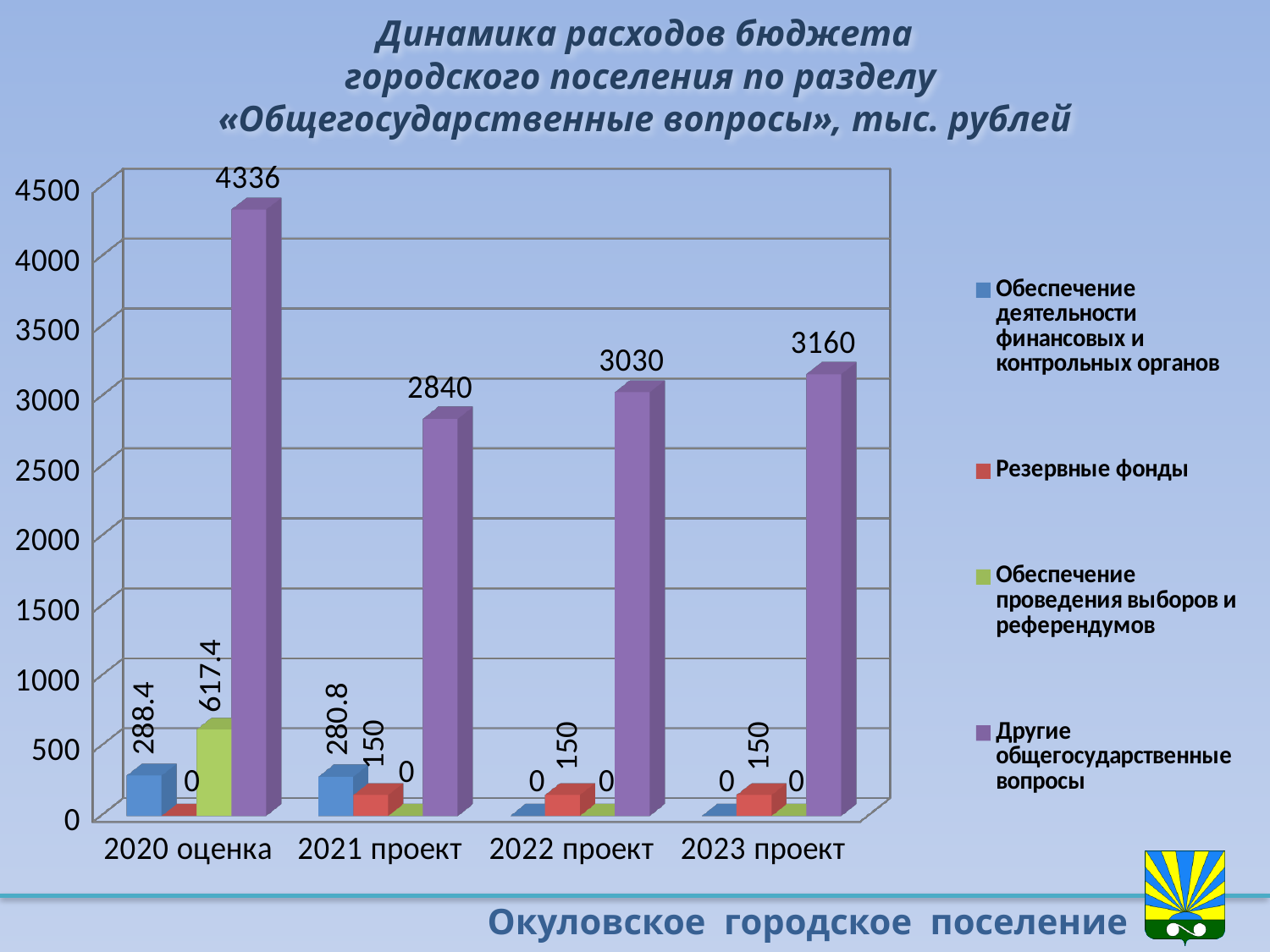
What is the value for «Обеспечение проведения выборов и референдумов» in 2020 оценка? 617.4 In which year is the value for «Другие общегосударственные вопросы» the lowest? 2021 проект What is the value for «Резервные фонды» in 2022 проект? 150 What kind of chart is shown on the slide? Bar chart What is the value for «Другие общегосударственные вопросы» in 2020 оценка? 4336 Does the value for «Другие общегосударственные вопросы» rise or fall from 2021 проект to 2023 проект? Rise How many year categories are shown on the x axis? 4 Which is larger: «Обеспечение деятельности финансовых и контрольных органов» in 2020 оценка or in 2021 проект? 2020 оценка How many series does the legend list? 4 In which year is the value for «Другие общегосударственные вопросы» the highest? 2020 оценка What is the difference between the «Другие общегосударственные вопросы» values for 2023 проект and 2022 проект? 130 What is the value for «Обеспечение деятельности финансовых и контрольных органов» in 2021 проект? 280.8